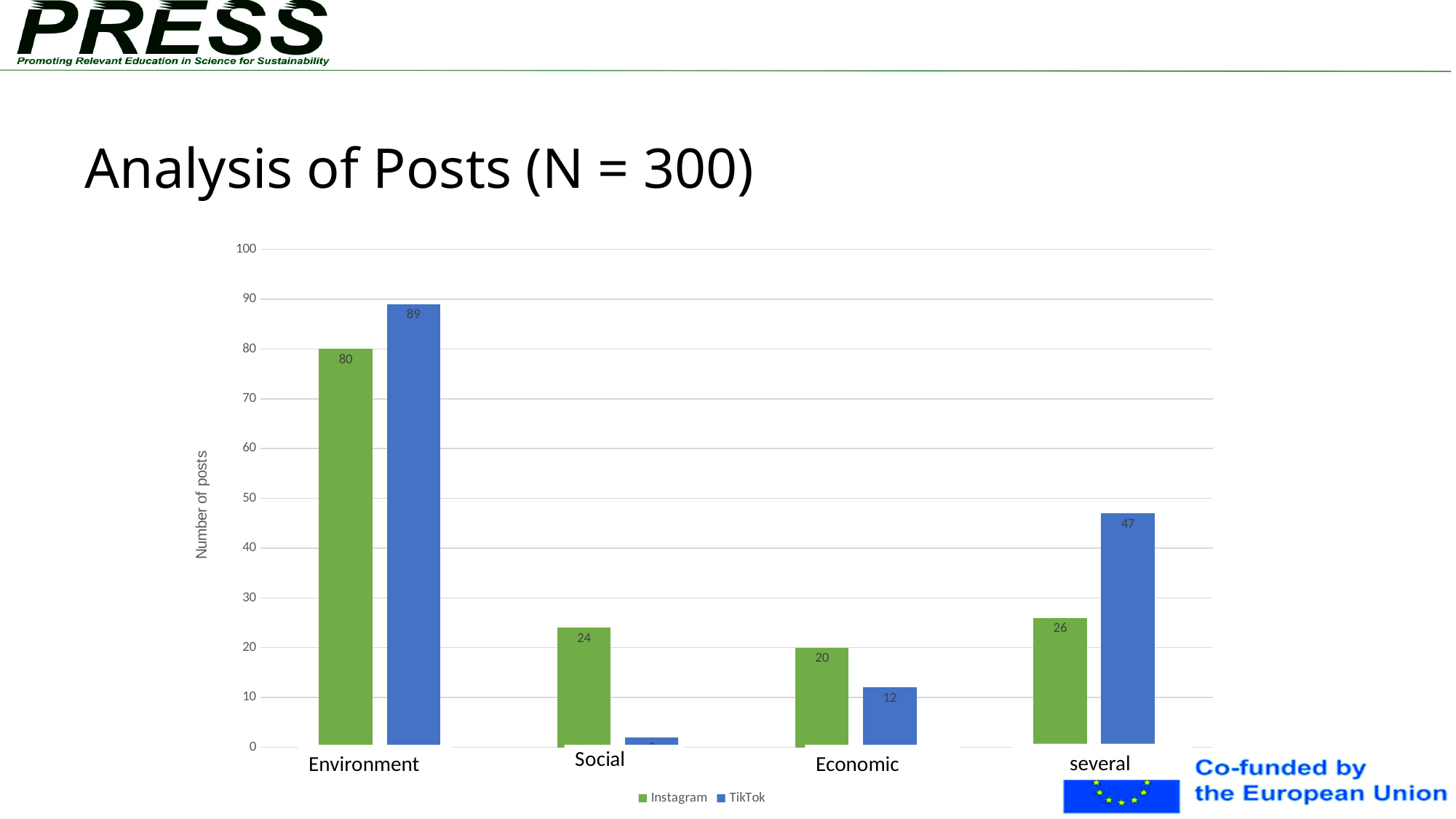
How many categories are shown on the x axis? 4 Which category has the highest number of TikTok posts? Environment What is the number of Instagram posts for Economic? 20 Is the value for TikTok posts in the Social category greater or less than 10? less What is the number of Instagram posts for Environment? 80 Which is larger for Social: Instagram posts or TikTok posts? Instagram What type of chart is shown on the slide? Bar chart What is the difference between TikTok and Instagram posts for Environment? 9 What is the number of TikTok posts for several? 47 How many series does the legend list? 2 Which category has the lowest number of Instagram posts? Economic What is the number of TikTok posts for Environment? 89